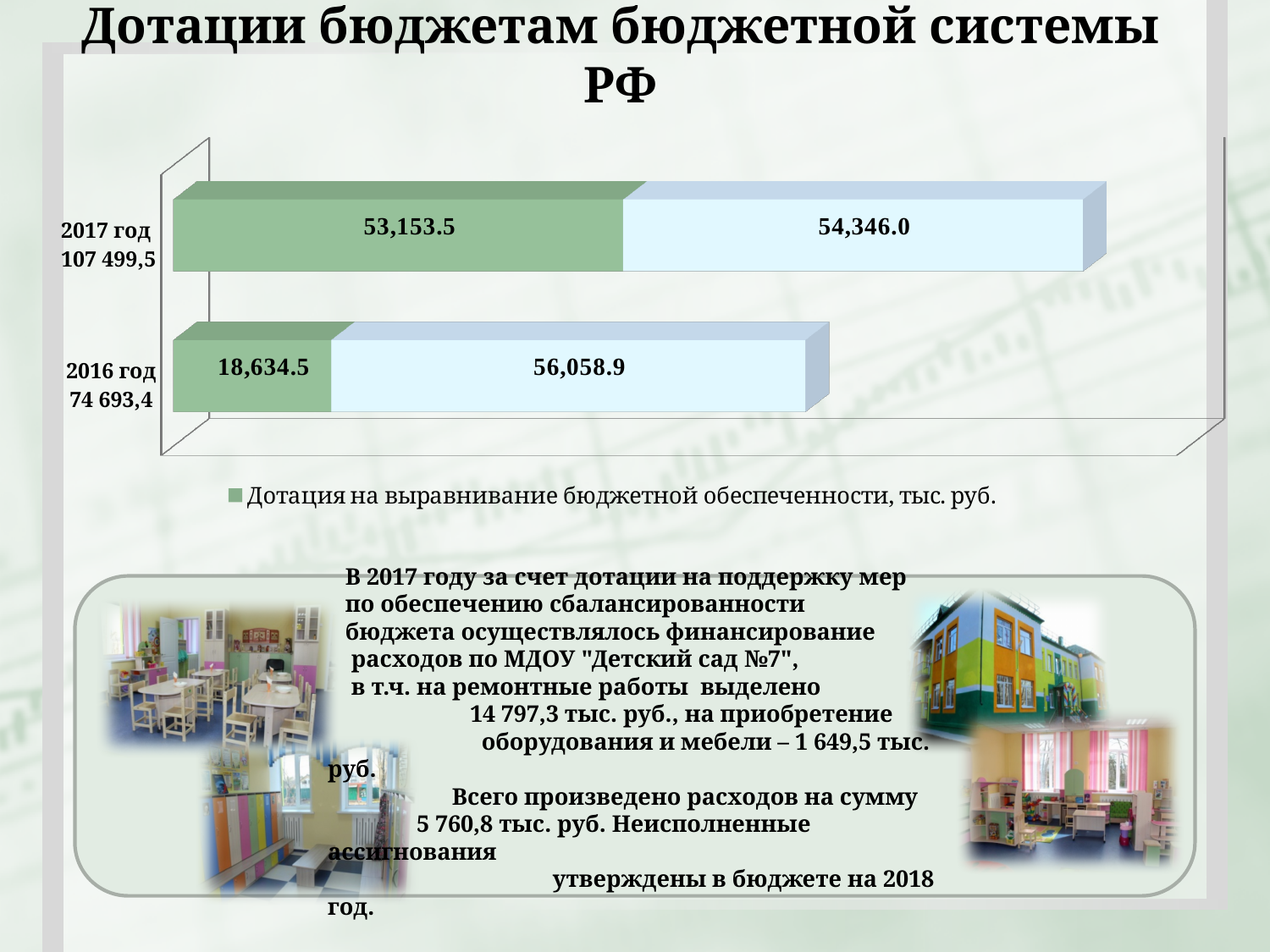
What is the total of the stacked bar for 2017 год, as shown on the axis label? 107 499,5 How many years (categories) are shown in the chart? 2 What is the value of the green segment (Дотация на выравнивание бюджетной обеспеченности) for 2017 год? 53,153.5 What is the total of the stacked bar for 2016 год, as shown on the axis label? 74 693,4 What type of chart is shown on the slide? bar chart What is the value of the light blue segment for 2016 год? 56,058.9 By how much does the green segment for 2017 год exceed the green segment for 2016 год? 34,519.0 What is the difference between the light blue segment for 2016 год and the light blue segment for 2017 год? 1,712.9 In 2017 год, which segment is larger: the green one or the light blue one? the light blue one (54,346.0) Which year has the larger green segment (Дотация на выравнивание бюджетной обеспеченности)? 2017 год What is the value of the green segment for 2016 год? 18,634.5 What is the value of the light blue segment for 2017 год? 54,346.0